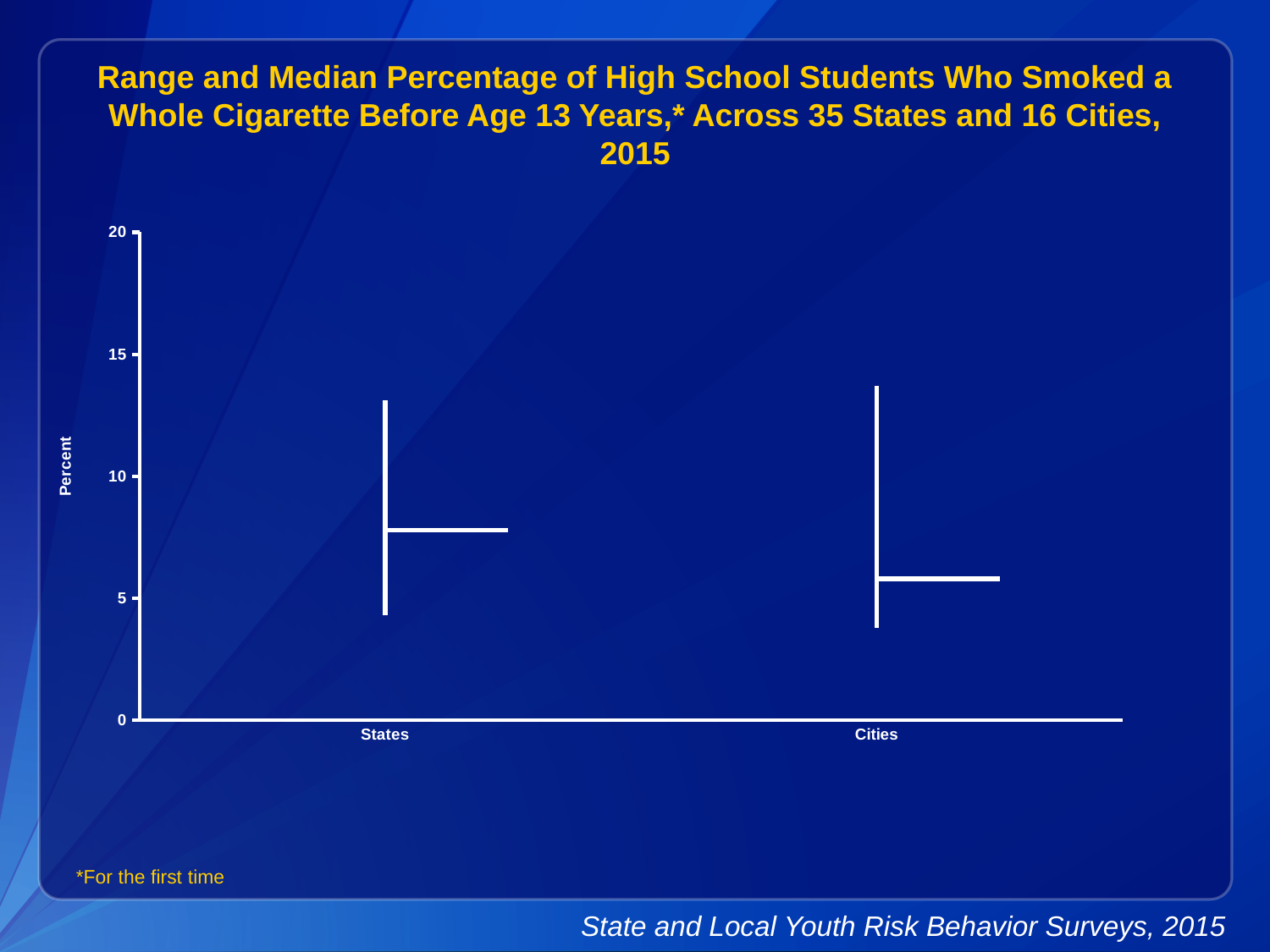
Is the median value for States greater or less than 10? less What is the maximum value shown on the y axis of the chart? 20 Is the top of the range for States greater or less than 15? less Is the median value for Cities greater or less than 5? greater Which category has the higher median percentage, States or Cities? States What is the title of the chart on the slide? Range and Median Percentage of High School Students Who Smoked a Whole Cigarette Before Age 13 Years,* Across 35 States and 16 Cities, 2015 What are the two categories shown on the x axis? States and Cities How many categories are shown on the x axis of the chart? 2